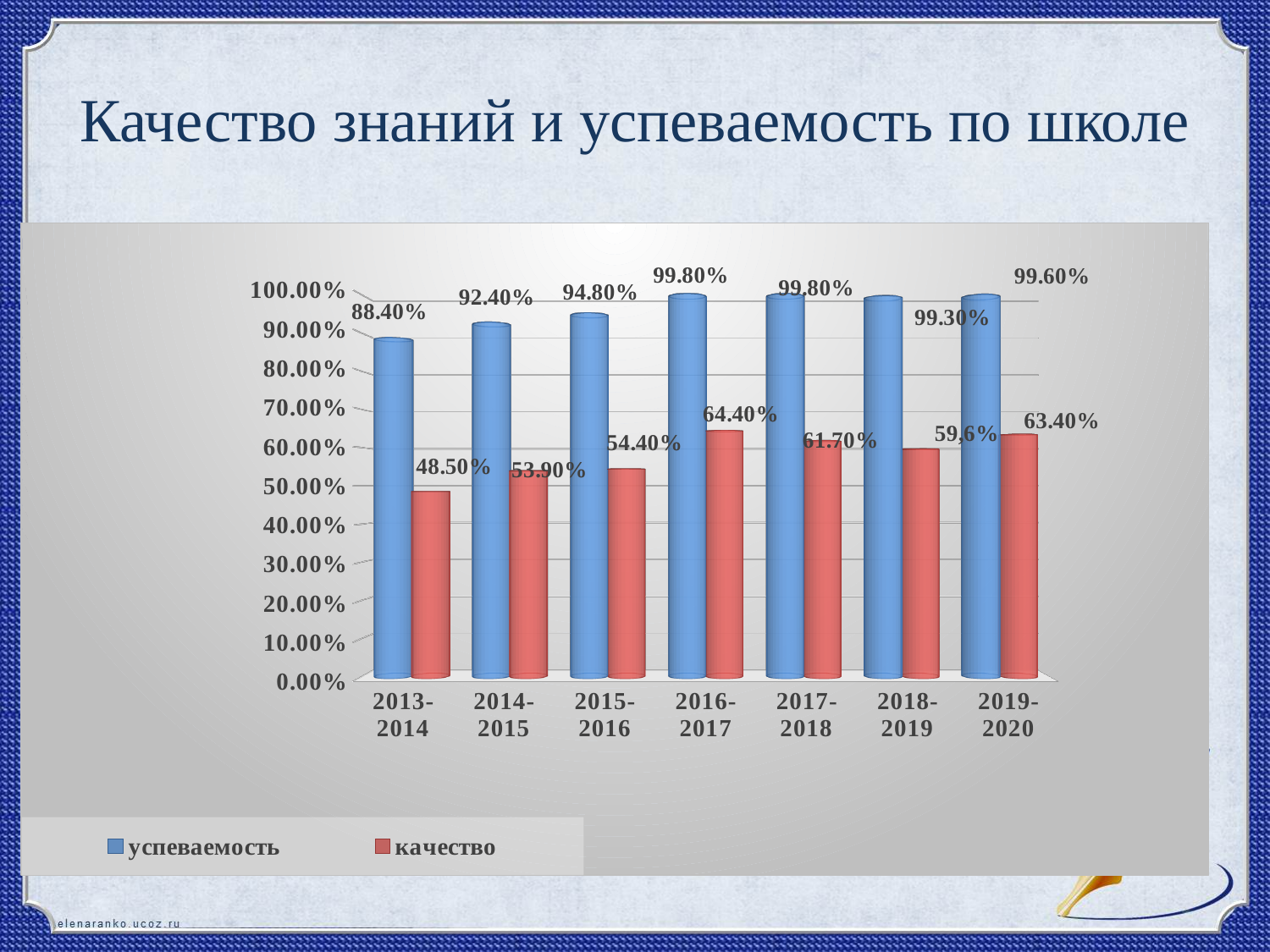
What is the value of качество for 2018-2019? 59,6% How many school years are shown on the x axis? 7 How many series does the legend list? 2 What is the value of успеваемость for 2013-2014? 88.40% In which school year is качество the highest? 2016-2017 What is the difference between успеваемость and качество in 2013-2014? 39.90% What kind of chart is shown on the slide? bar chart What is the value of качество for 2016-2017? 64.40% Does качество rise or fall from 2013-2014 to 2016-2017? rise In which school year is успеваемость the lowest? 2013-2014 What is the value of успеваемость for 2019-2020? 99.60% Which is larger: качество in 2017-2018 or качество in 2018-2019? 2017-2018